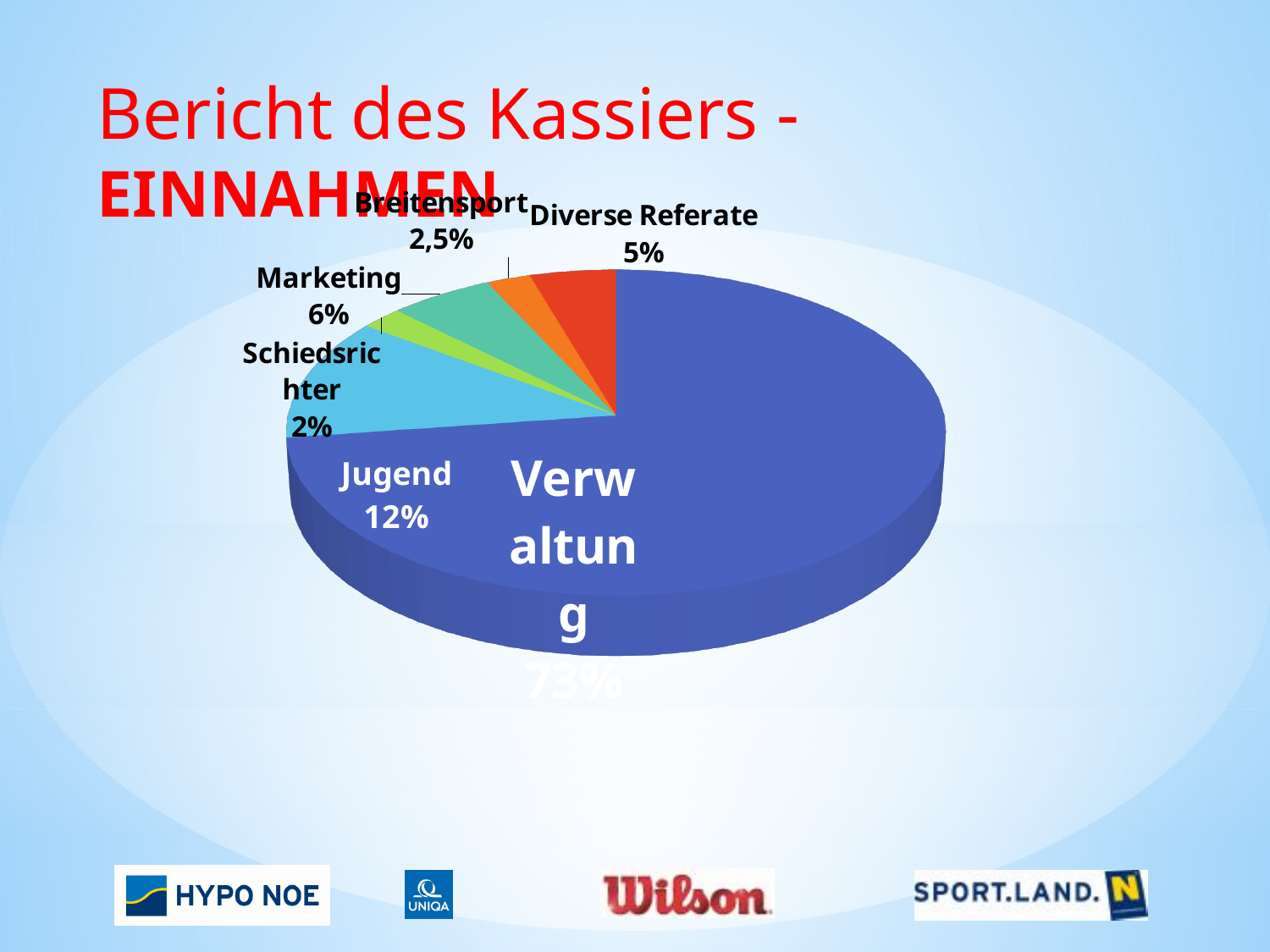
How many slices does the pie chart have? 6 What is the value shown for Diverse Referate? 5% What is the value shown for Breitensport? 2,5% What kind of chart is shown on the slide? pie chart Which is larger, the share for Marketing or the share for Diverse Referate? Marketing What is the value shown for Schiedsrichter? 2% What is the value shown for Marketing? 6% What share of the pie does Jugend account for? 12% What is the difference between the shares of Jugend and Marketing? 6% Which category has the largest slice of the pie? Verwaltung Which category has the smallest slice of the pie? Schiedsrichter What is the value shown for Verwaltung? 73%